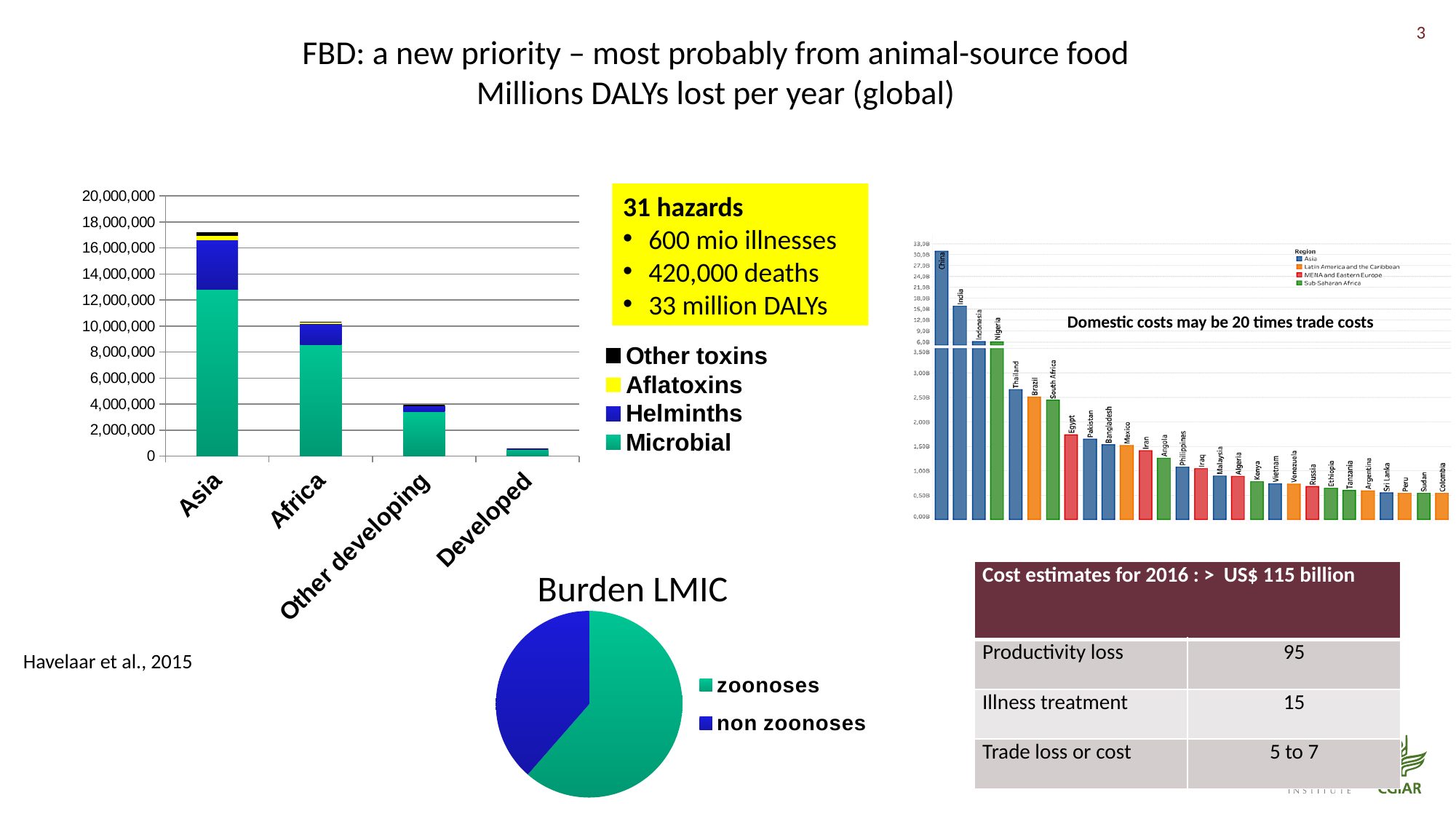
On the stacked bar chart on the left, do the totals rise or fall from Asia to Developed along the x axis? fall What kind of chart is the 'Burden LMIC' chart? pie chart On the stacked bar chart on the left, is the total value for Developed greater or less than 2,000,000? less On the stacked bar chart on the left, how many regions are shown on the x axis? 4 On the stacked bar chart on the left, how many series does the legend list? 4 On the stacked bar chart on the left, which series makes up the largest part of each bar? Microbial On the stacked bar chart on the left, which region has the lowest total DALYs lost? Developed On the 'Burden LMIC' pie chart, which slice is larger, zoonoses or non zoonoses? zoonoses On the stacked bar chart on the left, which region has the highest total DALYs lost? Asia On the stacked bar chart on the left, which is larger, the total for Asia or the total for Africa? Asia On the stacked bar chart on the left, is the total value for Asia greater or less than 16,000,000? greater On the bar chart on the right showing costs by country, which country has the highest value? China